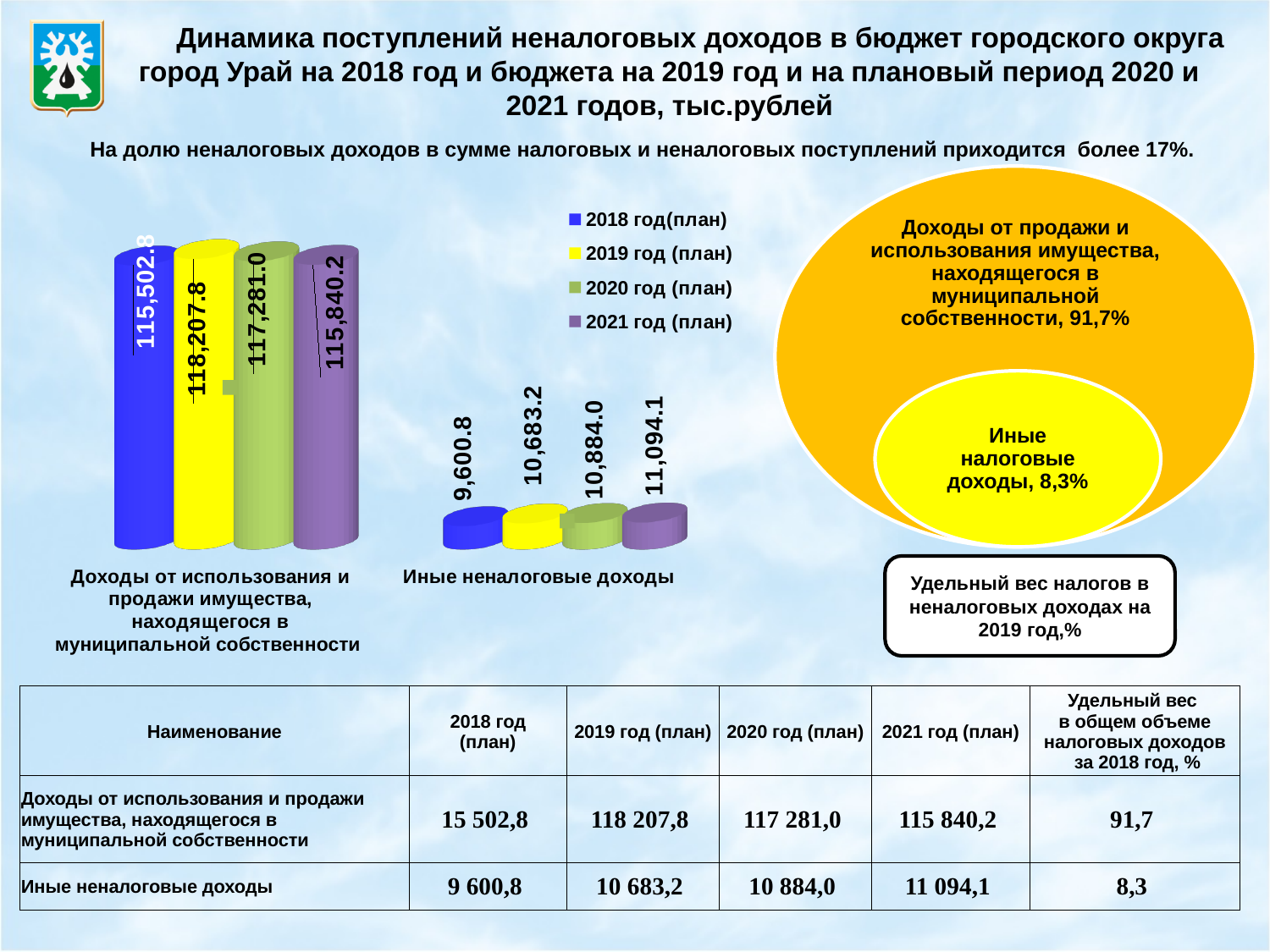
In the bar chart on the left, what is the value for 2021 год (план) for Иные неналоговые доходы? 11,094.1 In the bar chart on the left, what is the difference between the 2021 год (план) and 2018 год(план) values for Иные неналоговые доходы? 1,493.3 How many series does the legend of the bar chart on the left list? 4 In the chart on the right (Удельный вес налогов в неналоговых доходах на 2019 год,%), what share is shown for Иные налоговые доходы? 8,3% In the bar chart on the left, which year has the lowest value for Иные неналоговые доходы? 2018 год(план) In the bar chart on the left, what is the value for 2019 год (план) for Доходы от использования и продажи имущества, находящегося в муниципальной собственности? 118,207.8 In the bar chart on the left, which year has the highest value for Доходы от использования и продажи имущества, находящегося в муниципальной собственности? 2019 год (план) In the bar chart on the left, do the values for Иные неналоговые доходы rise or fall from 2018 to 2021? rise How many categories are shown in the bar chart on the left? 2 What kind of chart is the chart on the left of the slide? bar chart In the bar chart on the left, which is larger for Доходы от использования и продажи имущества: the 2020 год (план) value or the 2021 год (план) value? 2020 год (план) In the bar chart on the left, what is the value for 2020 год (план) for Иные неналоговые доходы? 10,884.0